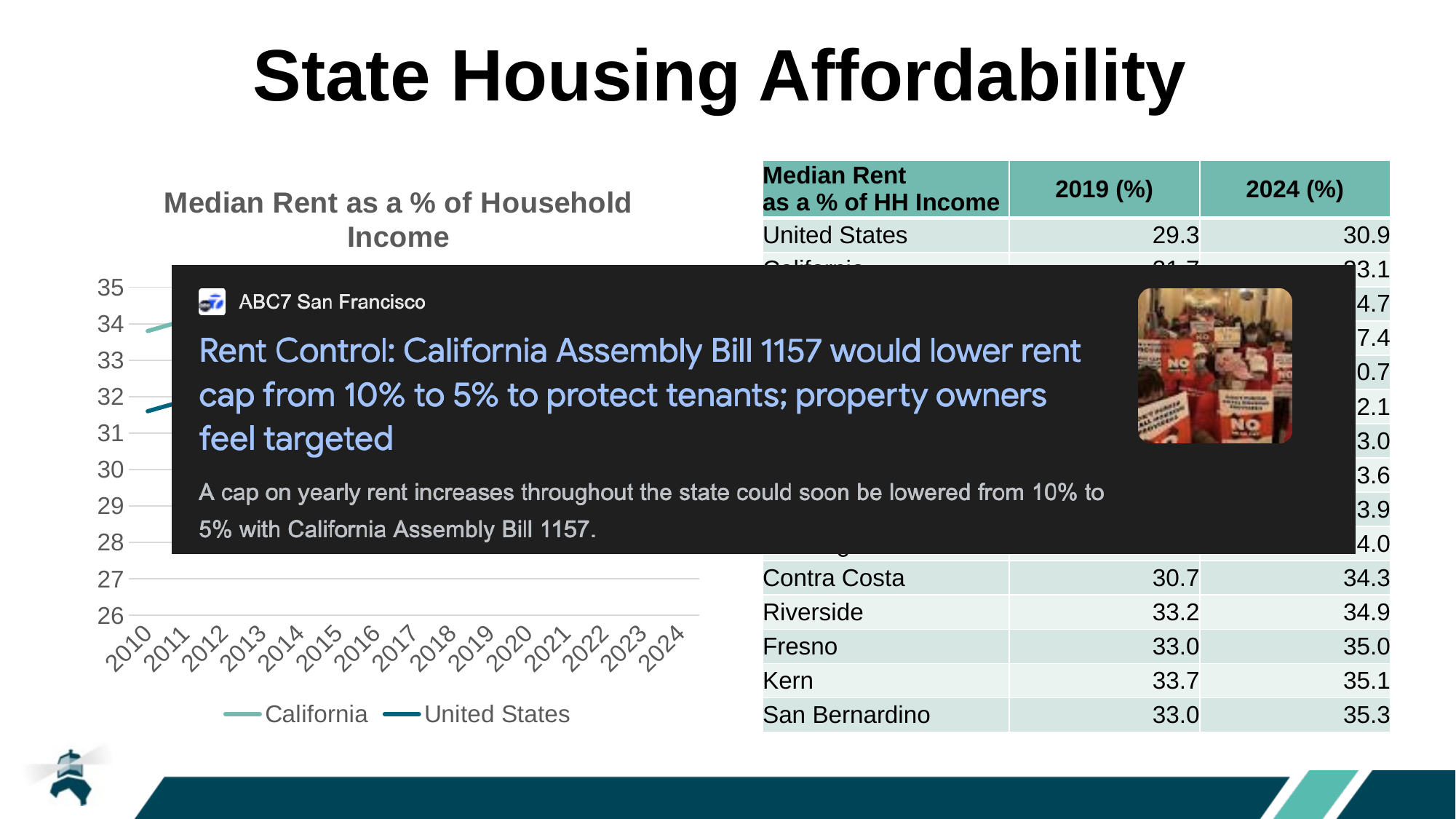
What kind of chart is shown on the left of the slide? line chart Which two series are listed in the chart's legend? California and United States How many years are shown on the chart's x axis? 15 Is the value for California in 2010 greater or less than 33? greater Is the value for United States in 2010 greater or less than 31? greater How many series does the legend of the chart list? 2 What is the highest value shown on the chart's y axis? 35 What is the first year shown on the chart's x axis? 2010 In 2010, which series has the higher value on the chart, California or United States? California What is the last year shown on the chart's x axis? 2024 What is the title of the chart on the left of the slide? Median Rent as a % of Household Income Is the value for United States in 2010 greater or less than 33? less